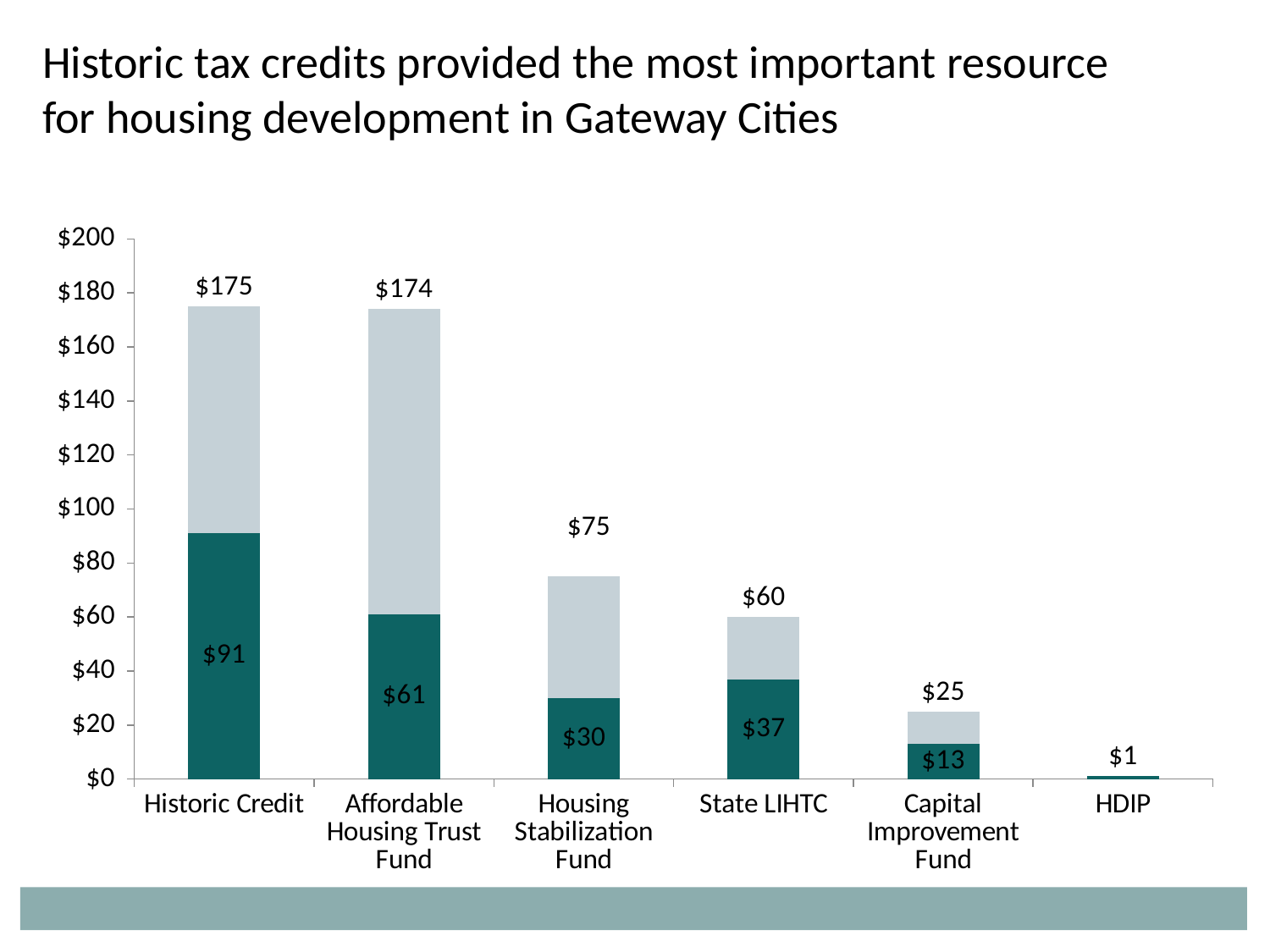
What type of chart is shown on the slide? stacked bar chart What is the value of the dark teal segment of the Affordable Housing Trust Fund bar? $61 How many categories are shown on the x axis of the chart? 6 What is the value of the dark teal segment of the Capital Improvement Fund bar? $13 What is the title of the slide containing the chart? Historic tax credits provided the most important resource for housing development in Gateway Cities What is the difference between the total for Historic Credit and the total for Affordable Housing Trust Fund? $1 What is the total value labeled above the Historic Credit bar? $175 What is the total value labeled above the State LIHTC bar? $60 Which category has the largest dark teal segment? Historic Credit What is the difference between the total for Housing Stabilization Fund and its dark teal segment? $45 Which category has the lowest total value? HDIP Which is larger, the dark teal segment for Housing Stabilization Fund or the dark teal segment for State LIHTC? State LIHTC